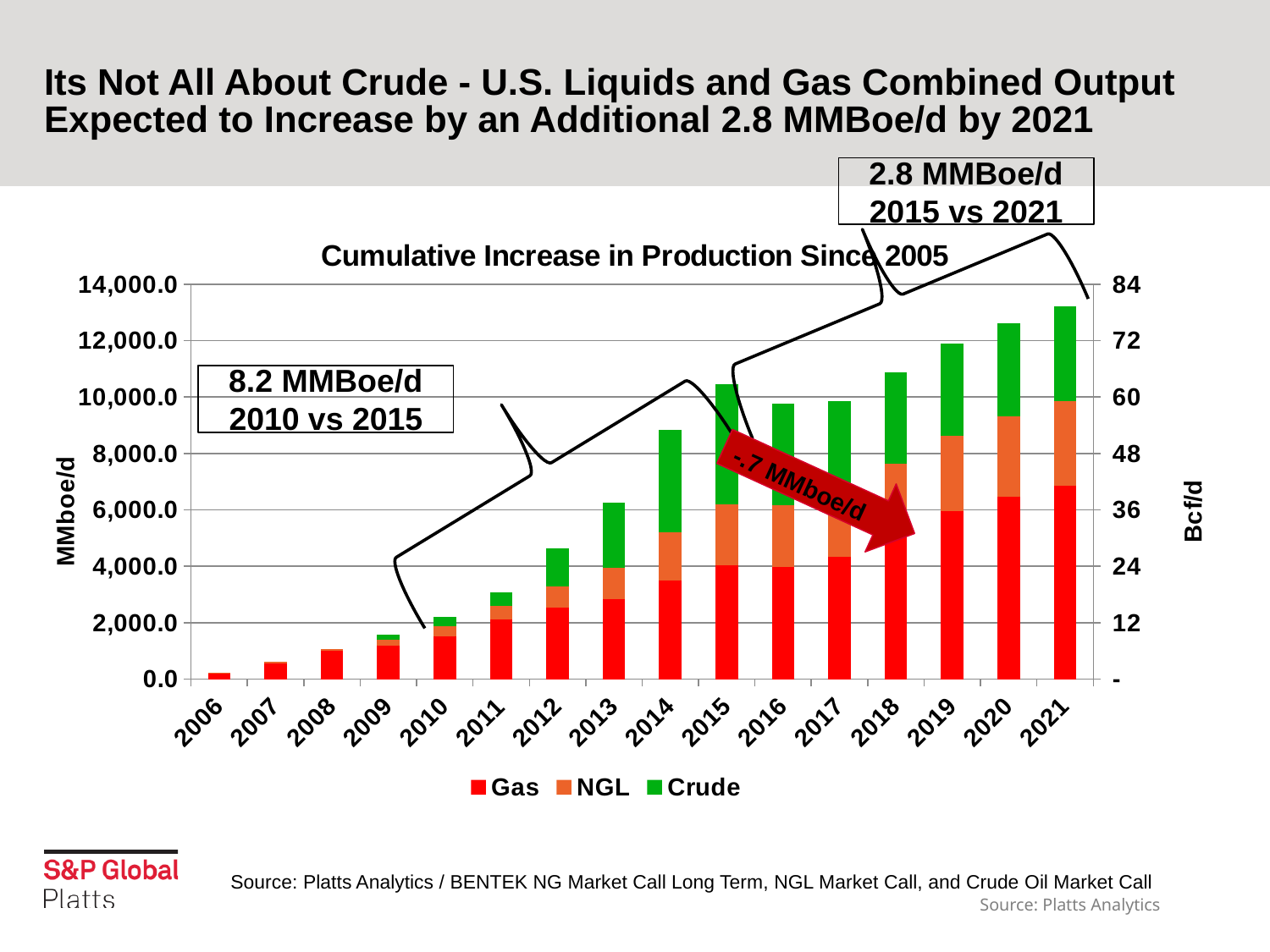
Which year has the lowest total cumulative increase in production? 2006 How many series does the legend list? 3 What kind of chart is shown on the slide? Stacked bar chart Is the total value for 2006 greater or less than 2,000.0 MMboe/d? less What is the title of the chart? Cumulative Increase in Production Since 2005 Which year has the highest total cumulative increase in production? 2021 Which year has the larger total, 2015 or 2021? 2021 Do the total bar heights generally rise or fall from 2006 to 2021? Rise Is the total value for 2014 greater or less than 8,000.0 MMboe/d? greater How many years are shown on the x axis? 16 Is the total value for 2021 greater or less than 12,000.0 MMboe/d? greater What is the label on the right-hand vertical axis? Bcf/d